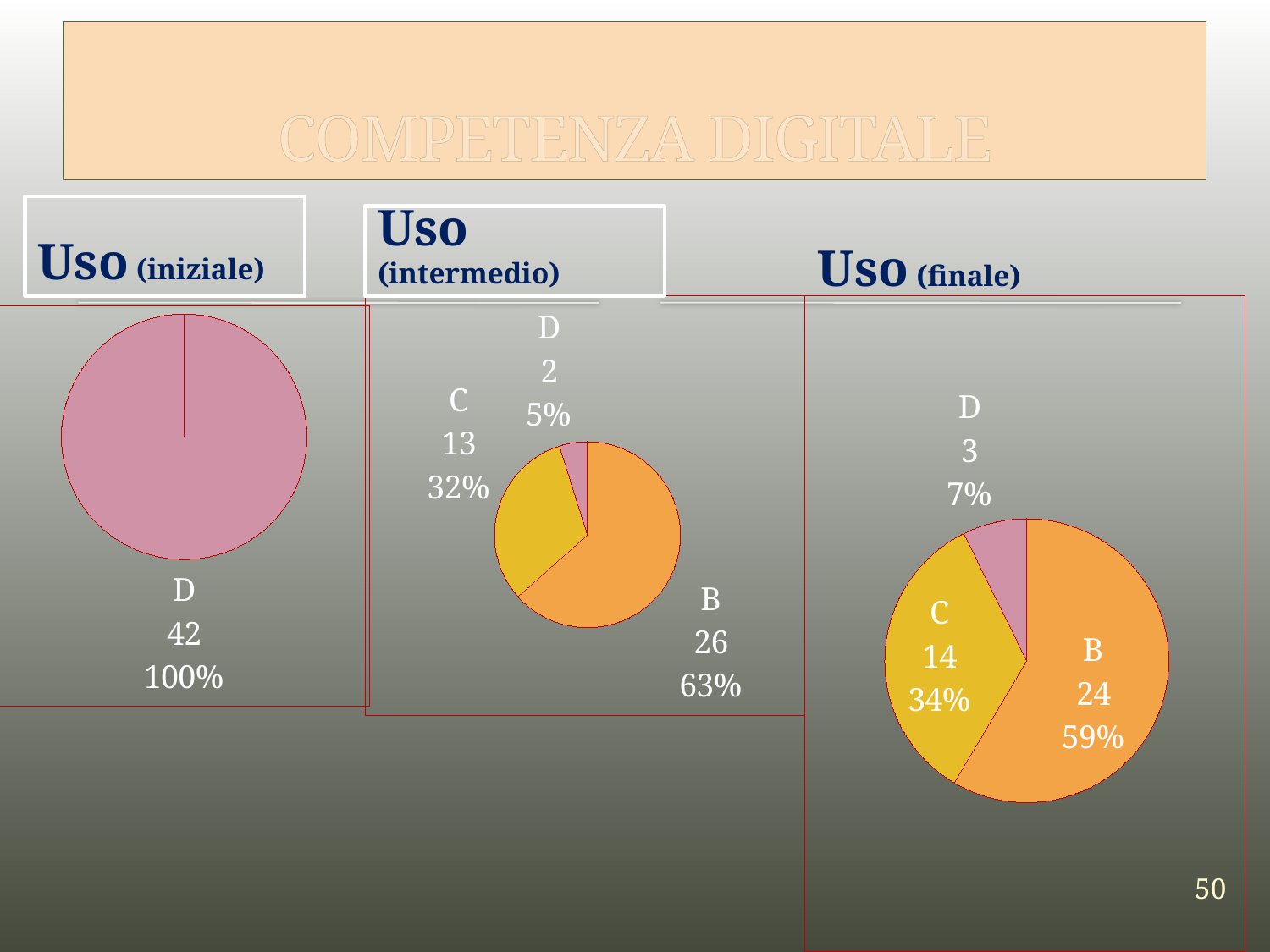
In the Uso (finale) chart, what percentage is shown for category B? 59% In the Uso (intermedio) chart, which category has the smallest slice? D In the Uso (finale) chart, what is the difference between the values for B and C? 10 In the Uso (iniziale) chart, what share of the pie does D hold? 100% In the Uso (intermedio) chart, what value is shown for category B? 26 In the Uso (finale) chart, is the value for B or for D larger? B In the Uso (iniziale) chart, what value is shown for category D? 42 In the Uso (finale) chart, which category has the largest slice? B What kind of chart is used for Uso (finale)? Pie chart In the Uso (finale) chart, what value is shown for category C? 14 In the Uso (intermedio) chart, what percentage is shown for category C? 32% In the Uso (intermedio) chart, how many slices does the pie have? 3